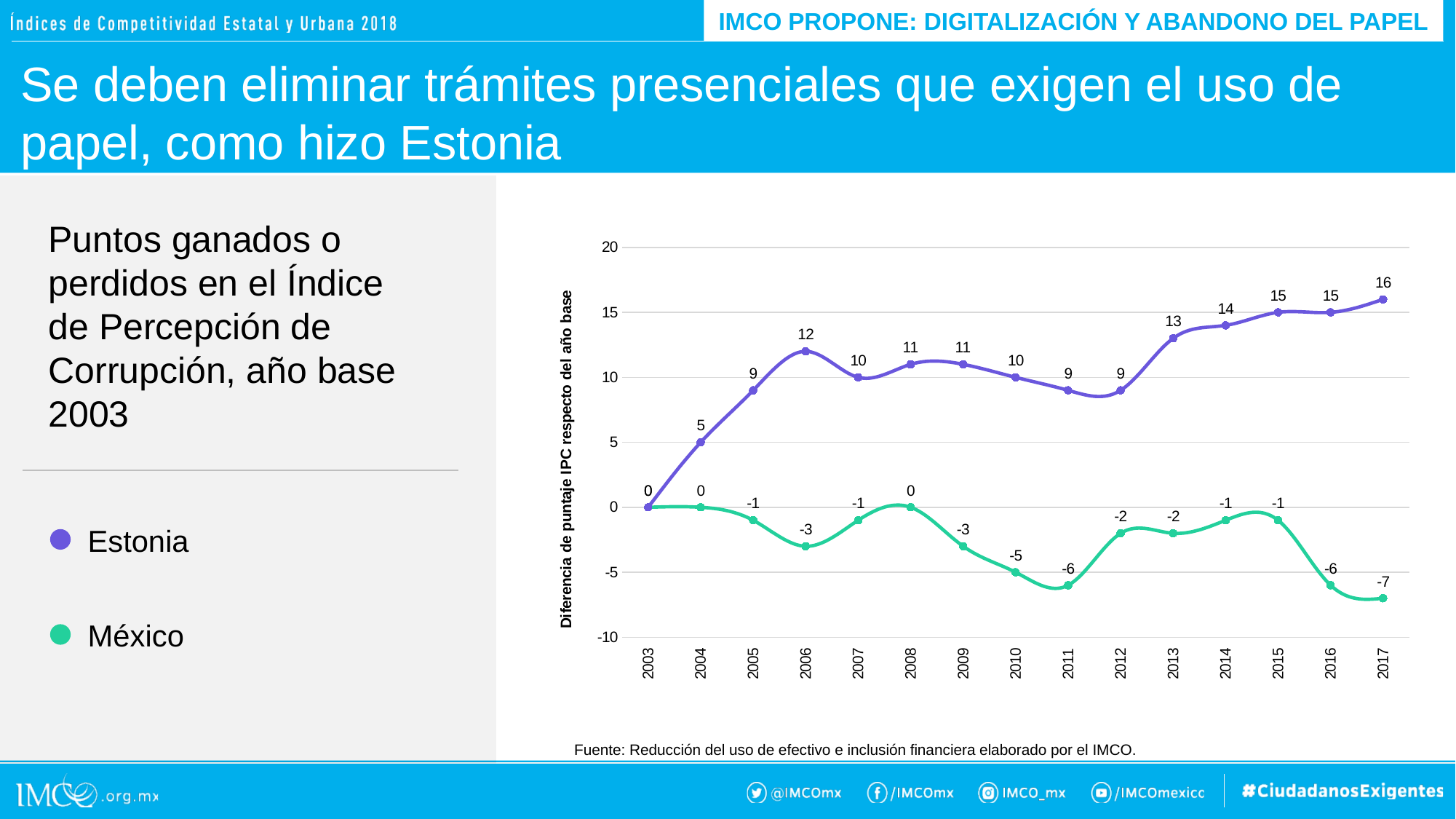
What kind of chart is shown on the slide? Line chart Which series has the larger value in 2010, Estonia or México? Estonia What is the value for México in 2011? -6 What is the difference between the Estonia and México values in 2017? 23 Does the Estonia series generally rise or fall from 2003 to 2017? Rise In which year does México reach its lowest value? 2017 What is the value for Estonia in 2006? 12 What is the value for Estonia in 2017? 16 What is the label of the y axis? Diferencia de puntaje IPC respecto del año base How many years are shown on the x axis? 15 In which year does Estonia reach its highest value? 2017 How many series does the legend list? 2